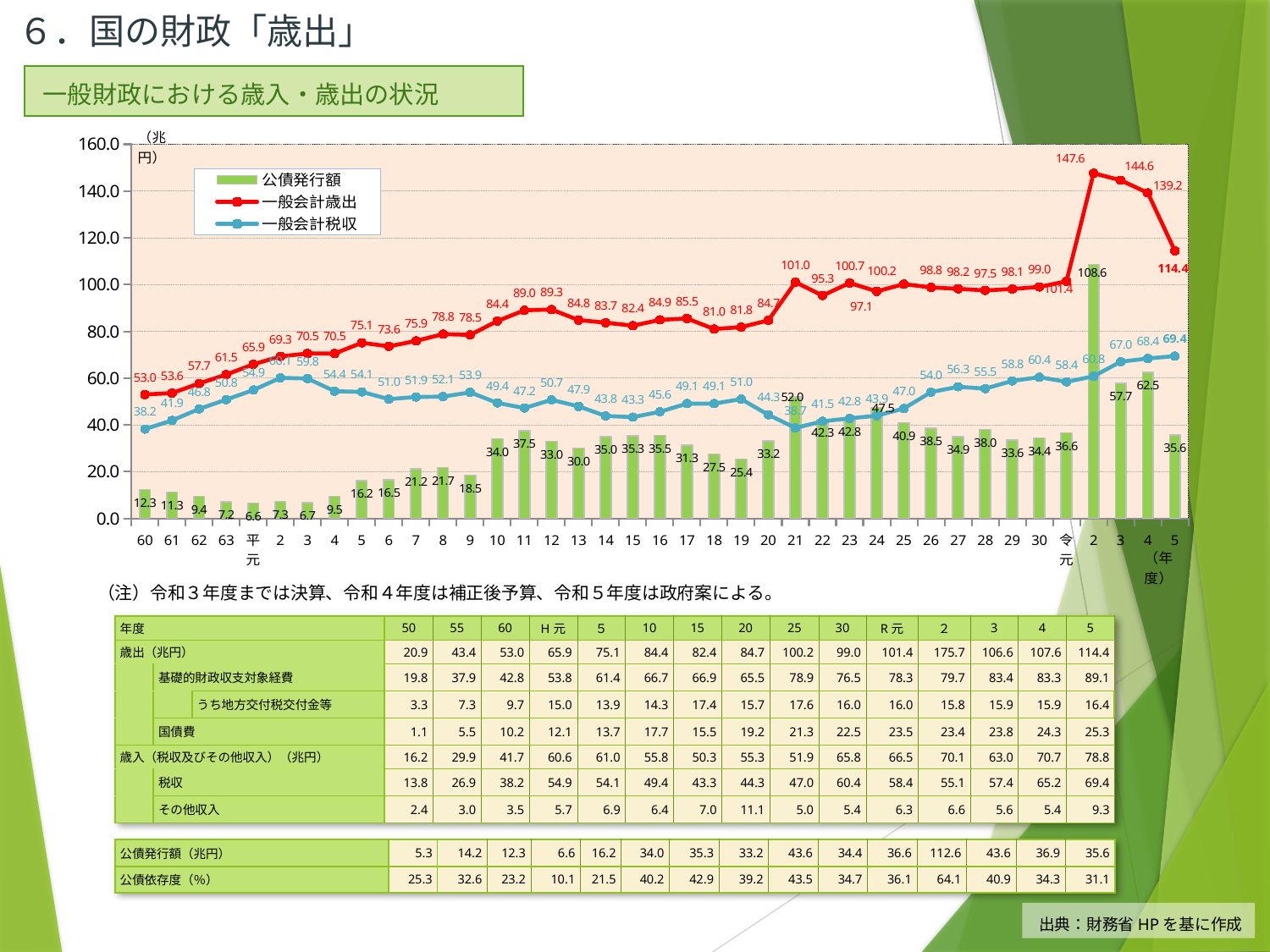
In which fiscal year does 一般会計歳出 reach its highest value on the chart? 令和2 What is the difference between 一般会計歳出 in 令和2年度 and 令和3年度? 3.0 In which fiscal year is the 公債発行額 bar the lowest on the chart? 平成元 What is the value of 一般会計歳出 for 令和5年度 on the chart? 114.4 How many series does the chart legend list? 3 What is the 公債発行額 for 令和2年度 on the chart? 108.6 What is the value of 一般会計税収 for 令和5年度 on the chart? 69.4 What kind of chart is shown on the slide? Combined bar and line chart Is the 公債発行額 for 令和2年度 greater or less than 100? greater What is the difference between 一般会計歳出 and 一般会計税収 in 令和5年度? 45.0 Which is larger in 平成21年度: 公債発行額 or 一般会計税収? 公債発行額 Does 一般会計歳出 rise or fall from 令和2年度 to 令和5年度? fall